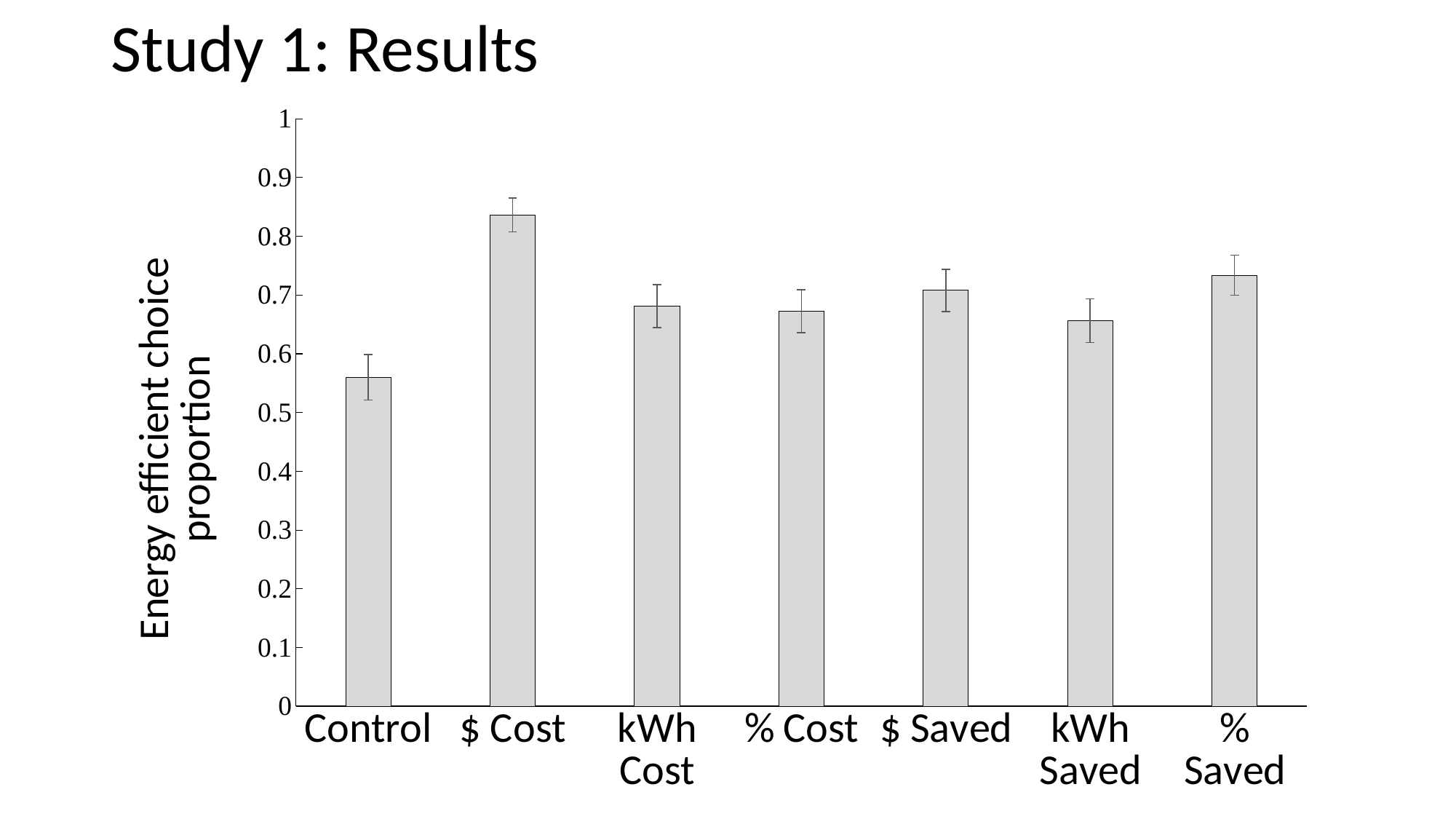
Is the value for kWh Cost greater or less than 0.7? less Which is larger, the value for % Saved or the value for kWh Saved? % Saved How many categories are plotted on the x axis? 7 Is the value for kWh Saved greater or less than 0.7? less Is the value for % Saved greater or less than 0.7? greater Which is larger, the value for $ Cost or the value for Control? $ Cost What is the label on the y axis of the chart? Energy efficient choice proportion Which category has the highest energy efficient choice proportion? $ Cost Which category has the lowest energy efficient choice proportion? Control What kind of chart is shown on the slide? bar chart